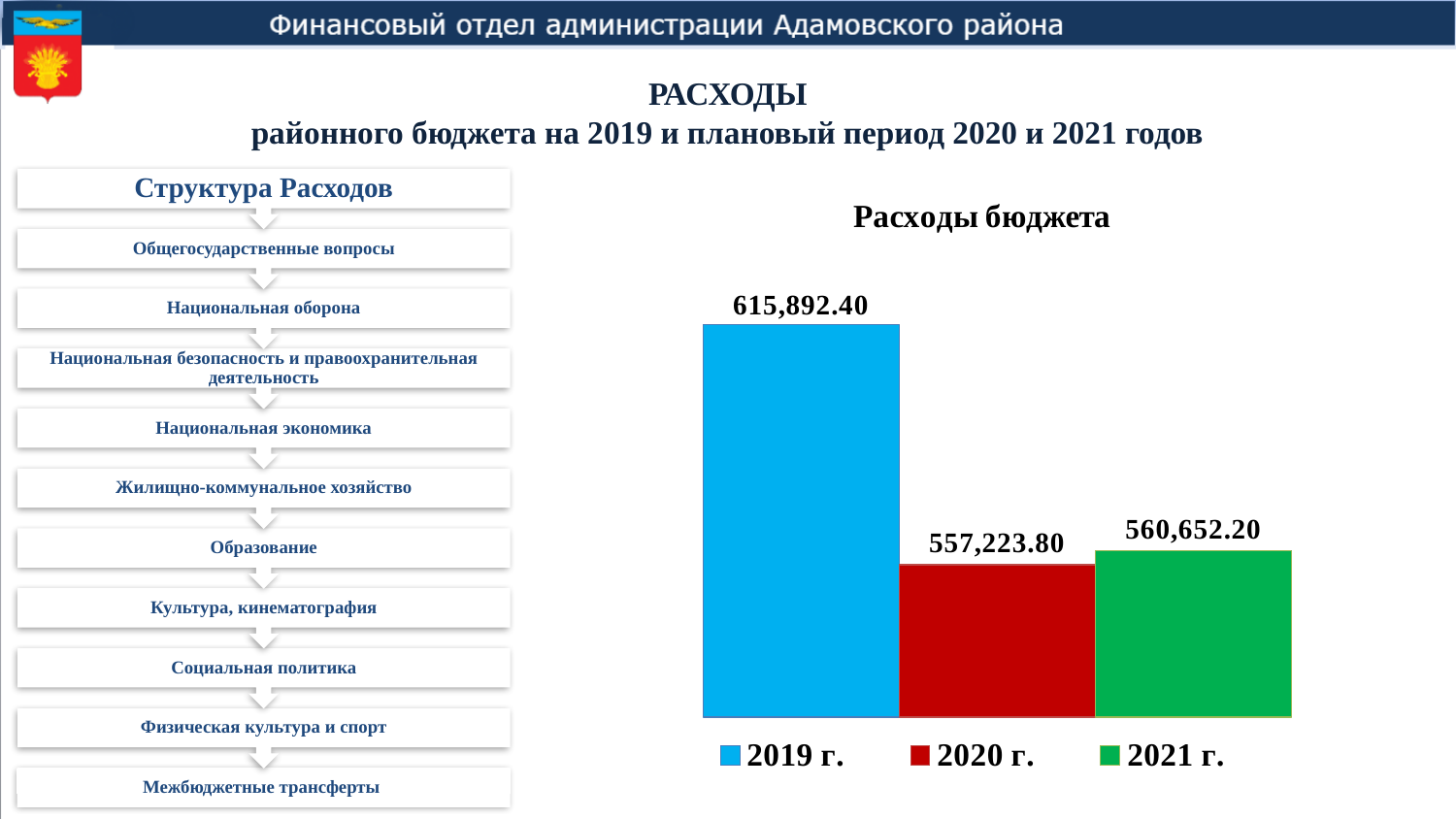
Which year has the lowest value in the Расходы бюджета chart? 2020 г. Which year has the highest value in the Расходы бюджета chart? 2019 г. What is the value for 2019 г. in the Расходы бюджета chart? 615,892.40 How many bars are shown in the Расходы бюджета chart? 3 What kind of chart is the Расходы бюджета chart? bar chart In the Расходы бюджета chart, which is larger: the value for 2020 г. or 2021 г.? 2021 г. What is the value for 2021 г. in the Расходы бюджета chart? 560,652.20 What is the difference between the values for 2021 г. and 2020 г. in the Расходы бюджета chart? 3,428.40 What colour is the bar for 2020 г. in the Расходы бюджета chart? red How many entries does the legend of the Расходы бюджета chart list? 3 What is the difference between the values for 2019 г. and 2020 г. in the Расходы бюджета chart? 58,668.60 What is the value for 2020 г. in the Расходы бюджета chart? 557,223.80